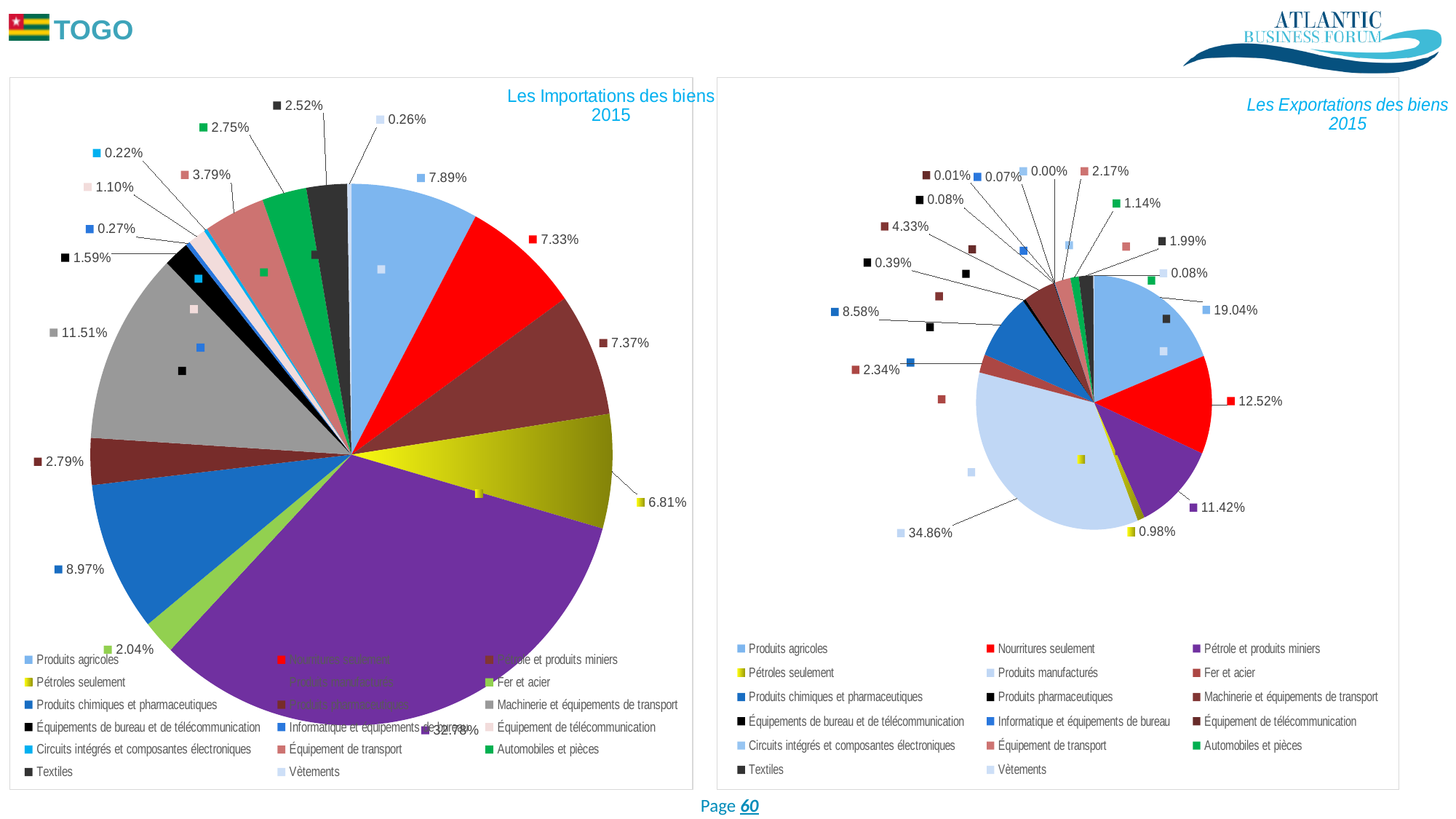
In the 'Les Importations des biens 2015' chart, what is the share for Machinerie et équipements de transport? 11.51% In the 'Les Importations des biens 2015' chart, what is the difference between Machinerie et équipements de transport and Produits chimiques et pharmaceutiques? 2.54% In the 'Les Importations des biens 2015' chart, what is the share for Produits manufacturés? 32.78% In the 'Les Exportations des biens 2015' chart, which is larger: Textiles or Pétroles seulement? Textiles In the 'Les Exportations des biens 2015' chart, what is the difference between Produits agricoles and Nourritures seulement? 6.52% In the 'Les Importations des biens 2015' chart, which is larger: Produits agricoles or Pétroles seulement? Produits agricoles In the 'Les Exportations des biens 2015' chart, what is the share for Produits agricoles? 19.04% In the 'Les Importations des biens 2015' chart, which category has the largest share? Produits manufacturés In the 'Les Exportations des biens 2015' chart, which category has the largest share? Produits manufacturés How many categories does the legend of the 'Les Exportations des biens 2015' chart list? 17 What type of chart is used for 'Les Importations des biens 2015'? Pie chart In the 'Les Exportations des biens 2015' chart, what is the share for Pétrole et produits miniers? 11.42%